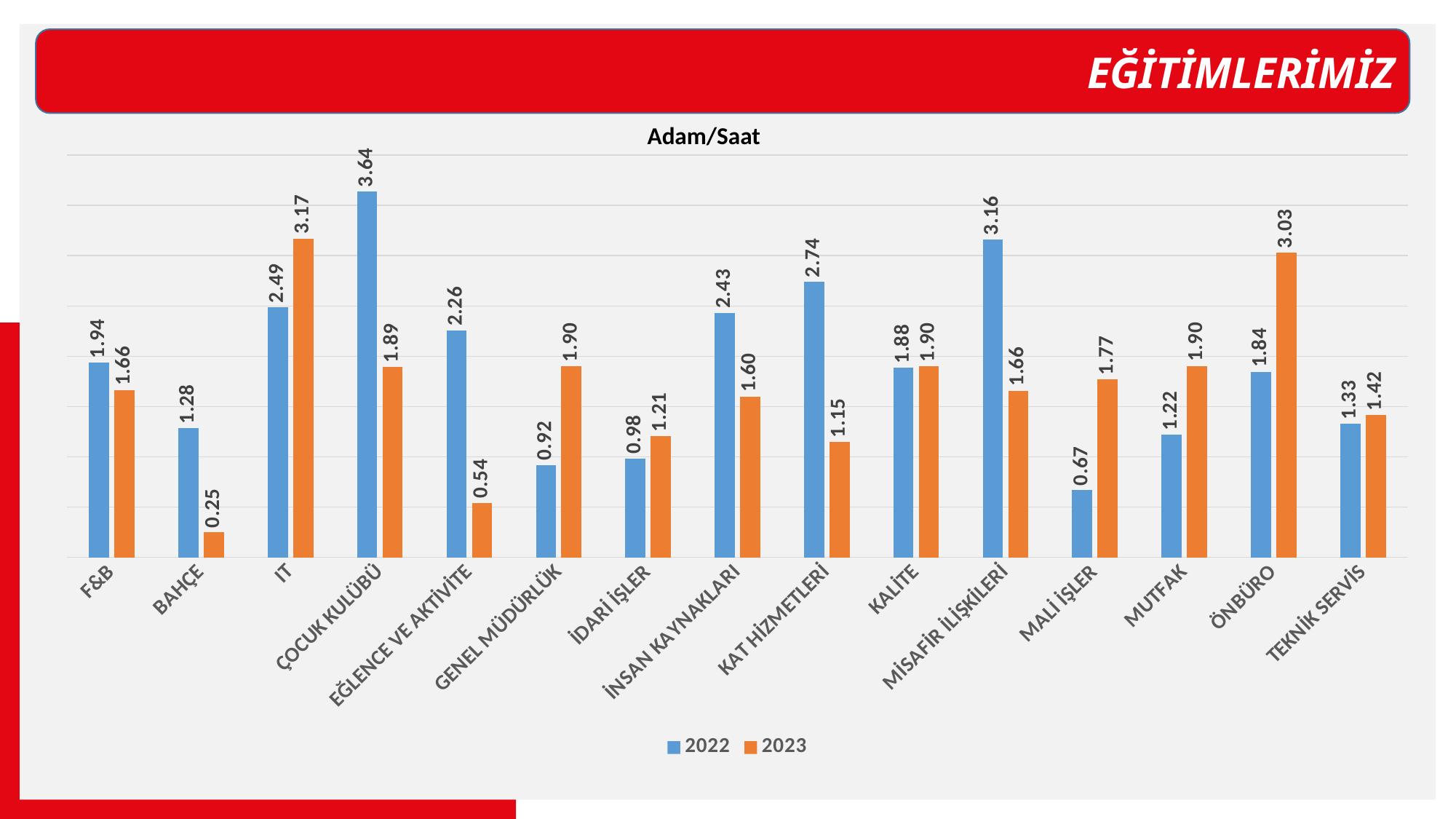
What is the 2023 value for ÖNBÜRO? 3.03 Which category has the lowest 2022 value? MALİ İŞLER What is the title of the chart? Adam/Saat How many categories are shown on the x axis? 15 Which category has the lowest 2023 value? BAHÇE Which is larger for IT: the 2022 value or the 2023 value? 2023 What is the 2023 value for BAHÇE? 0.25 How many series does the legend list? 2 Which category has the highest 2022 value? ÇOCUK KULÜBÜ What is the 2022 value for ÇOCUK KULÜBÜ? 3.64 What kind of chart is shown? Bar chart What is the difference between the 2022 and 2023 values for KAT HİZMETLERİ? 1.59